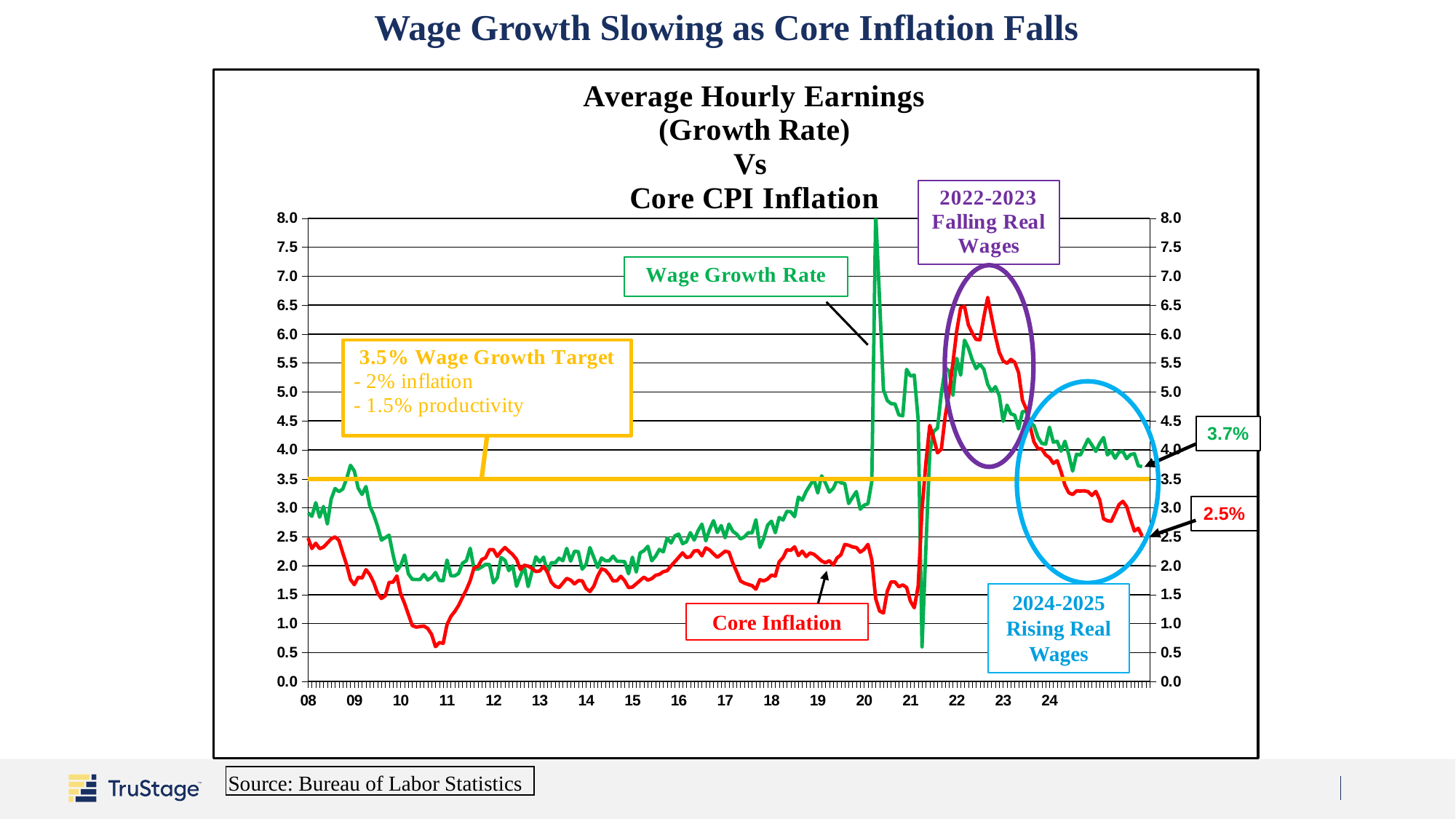
What is the latest labeled value of the Wage Growth Rate series? 3.7% What is the latest labeled value of the Core Inflation series? 2.5% From 2023 to the end of the chart, does the Wage Growth Rate series rise or fall? fall What kind of chart is shown on the slide? line chart Which series reaches the highest peak anywhere on the chart? Wage Growth Rate What is the difference between the latest labeled Wage Growth Rate (3.7%) and the latest labeled Core Inflation (2.5%)? 1.2% At the right end of the chart, which series is higher: Wage Growth Rate or Core Inflation? Wage Growth Rate What value is the horizontal Wage Growth Target line set at? 3.5% What does the purple annotation box above the purple circle say? 2022-2023 Falling Real Wages Is the lowest point of the Core Inflation series around 2011 greater or less than 1.0? less Is the peak of the Wage Growth Rate series around 2020 greater or less than 7.0? greater Is the peak of the Core Inflation series in 2022 greater or less than 6.0? greater